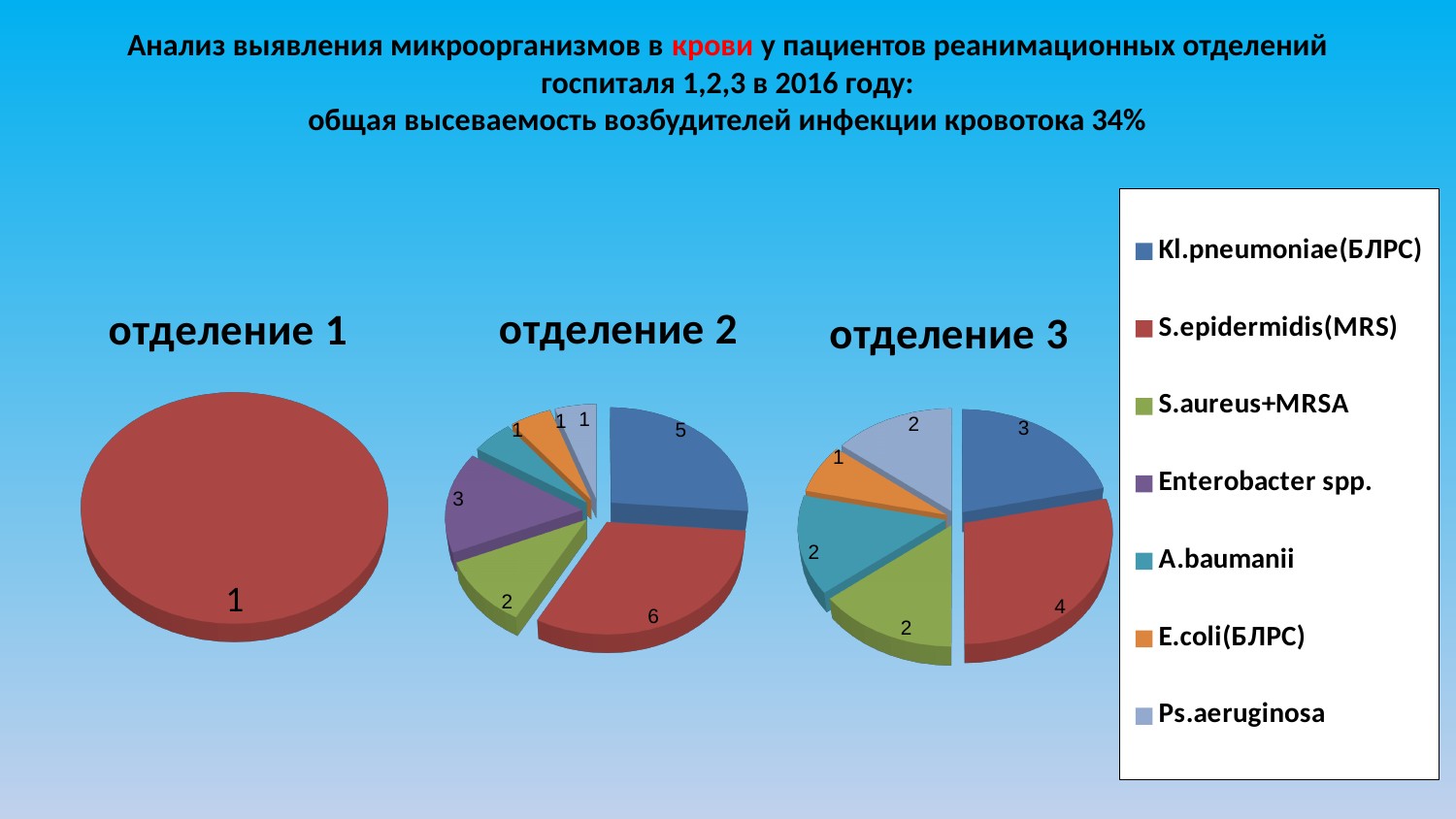
In the chart titled 'отделение 3', what is the value for Kl.pneumoniae(БЛРС)? 3 In the chart titled 'отделение 1', what value is shown on the single slice? 1 In the chart titled 'отделение 2', what is the total of all slice values? 19 In the chart titled 'отделение 3', which category has the largest slice? S.epidermidis(MRS) In the chart titled 'отделение 2', what is the value for Enterobacter spp.? 3 What kind of charts are shown on the slide? Pie charts In the chart titled 'отделение 2', what is the difference between the values for S.epidermidis(MRS) and Kl.pneumoniae(БЛРС)? 1 How many entries does the legend list? 7 In the chart titled 'отделение 3', which is larger: Kl.pneumoniae(БЛРС) or S.epidermidis(MRS)? S.epidermidis(MRS) In the chart titled 'отделение 2', which category has the largest slice? S.epidermidis(MRS) How many slices does the chart titled 'отделение 3' have? 6 In the chart titled 'отделение 2', what is the value for S.epidermidis(MRS)? 6